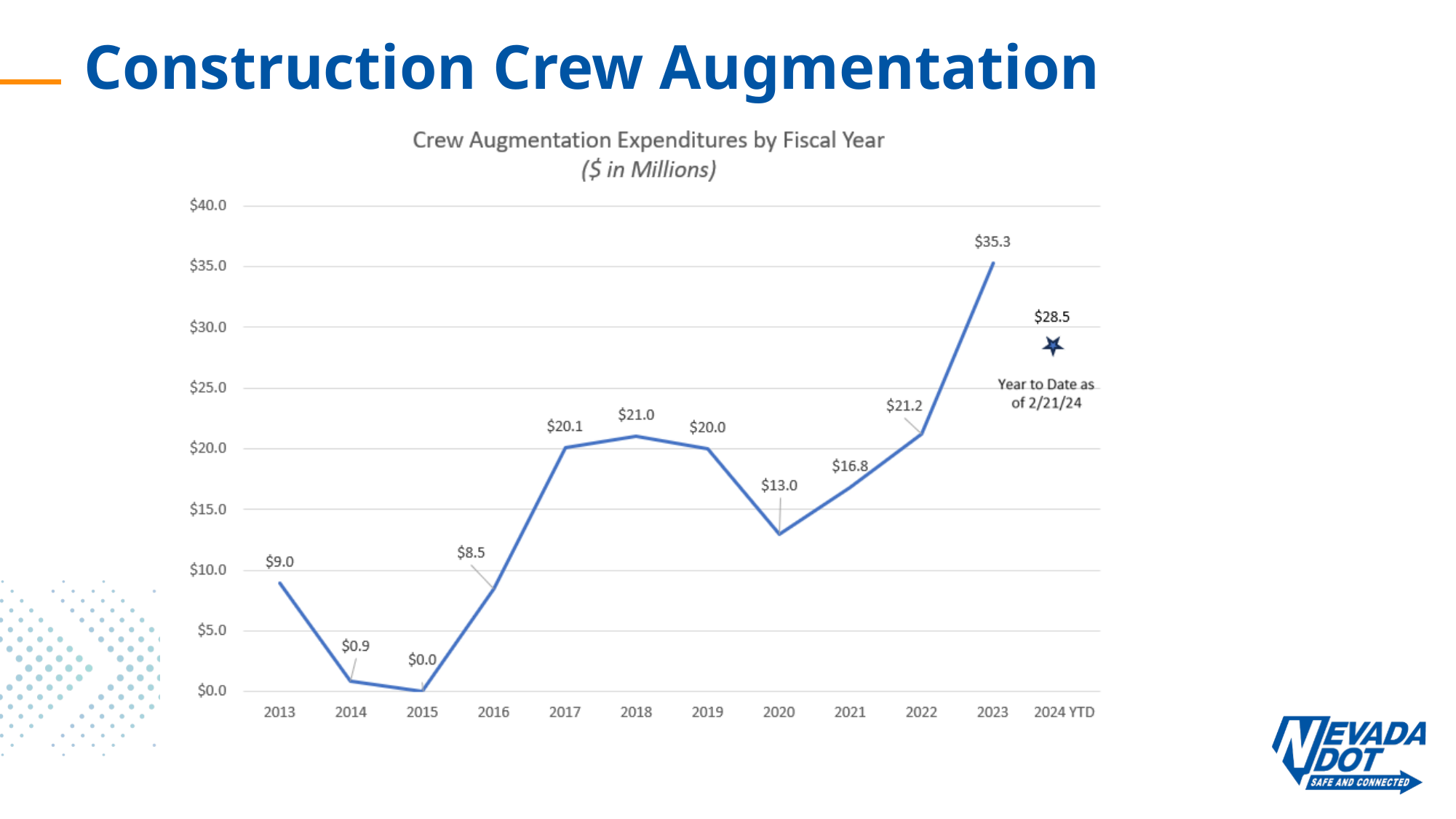
Which year had a higher expenditure, 2018 or 2019? 2018 What kind of chart is shown on the slide? Line chart Do the expenditures rise or fall from 2020 to 2023? Rise What is the crew augmentation expenditure for fiscal year 2020? $13.0 As of what date is the 2024 YTD value reported? 2/21/24 What is the title of the chart? Crew Augmentation Expenditures by Fiscal Year ($ in Millions) Which fiscal year has the lowest crew augmentation expenditure? 2015 What is the value shown for 2024 YTD? $28.5 What is the crew augmentation expenditure for fiscal year 2023? $35.3 What is the difference between the 2023 and 2022 expenditures? $14.1 How many fiscal year categories are shown on the x axis? 12 Which fiscal year has the highest crew augmentation expenditure? 2023